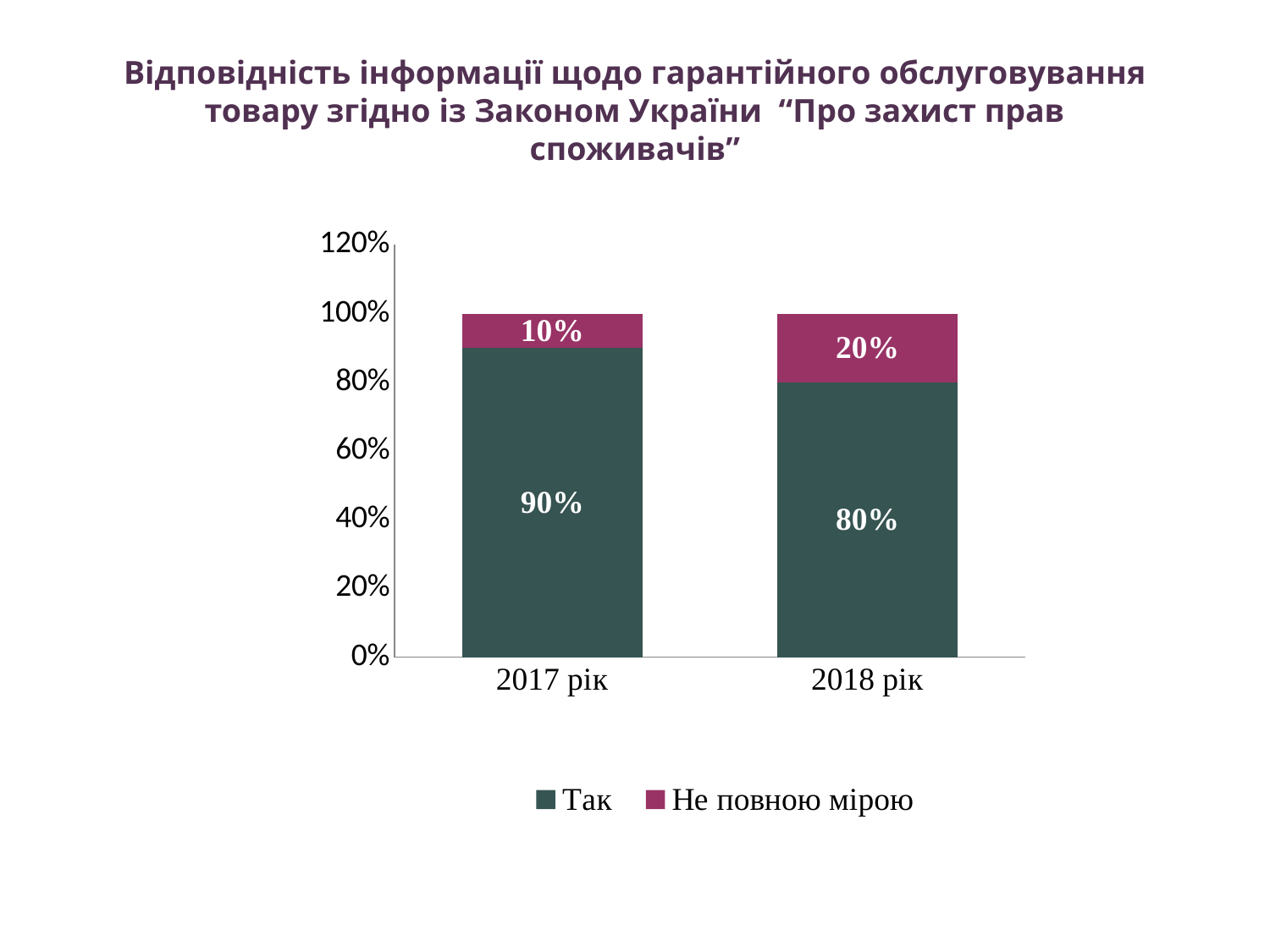
How many categories are shown on the x axis? 2 What is the value for "Не повною мірою" in 2017 рік? 10% Which year has the lower value for "Не повною мірою"? 2017 рік Which year has the higher value for "Так"? 2017 рік What is the total of the stacked bar for 2018 рік? 100% What kind of chart is shown on the slide? Stacked bar chart How many series does the legend list? 2 Is the "Не повною мірою" value larger in 2017 рік or 2018 рік? 2018 рік What is the difference between the "Так" values for 2017 рік and 2018 рік? 10% What is the value for "Не повною мірою" in 2018 рік? 20% What is the value for "Так" in 2017 рік? 90% What is the value for "Так" in 2018 рік? 80%